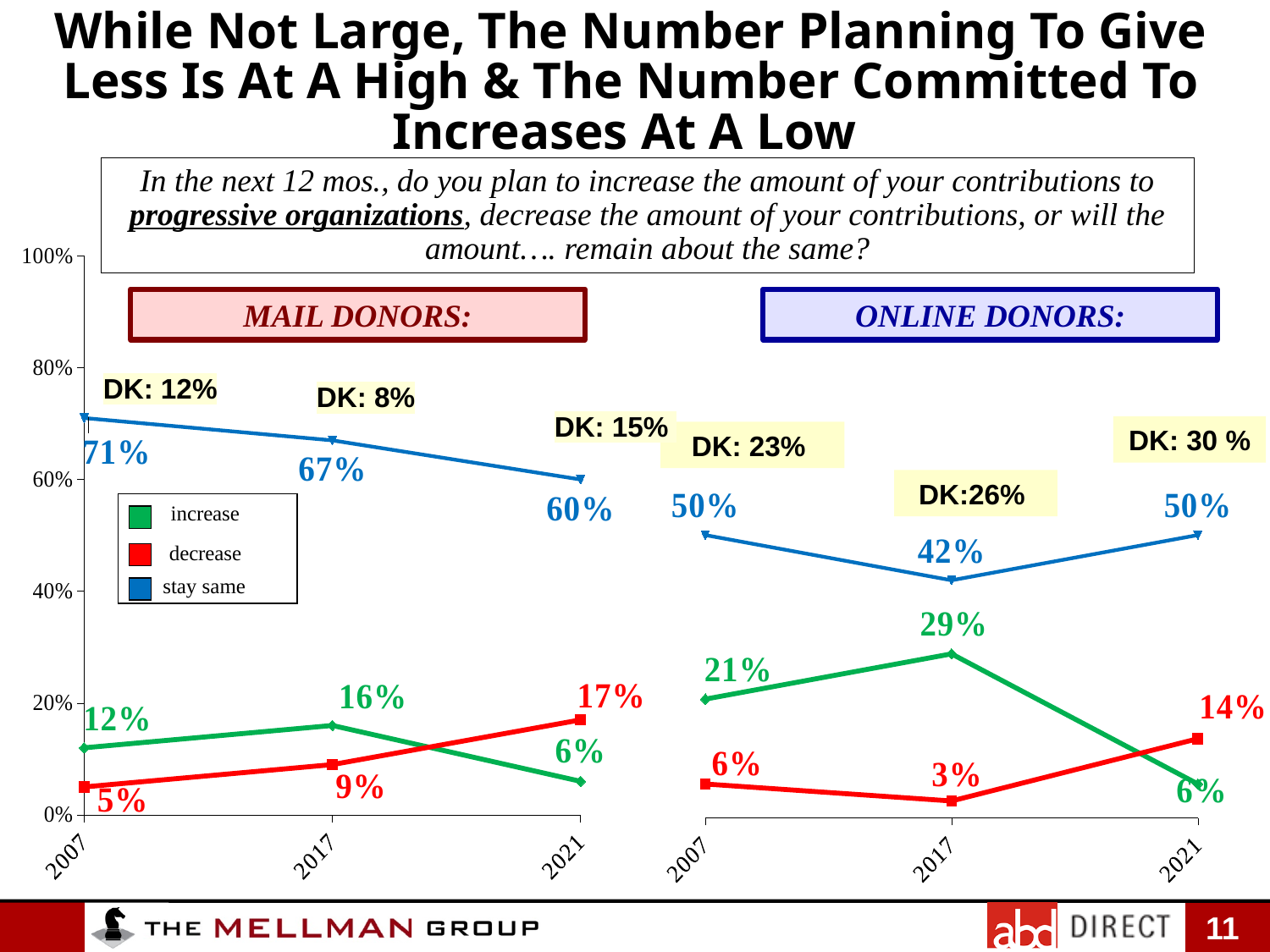
In the Mail Donors chart, what percentage planned to decrease contributions in 2021? 17% In the Online Donors chart, what percentage planned to decrease contributions in 2017? 3% In the Mail Donors chart, what percentage said they would stay the same in 2007? 71% How many series does the legend list? 3 In the Online Donors chart, in which year was the 'stay same' value lowest? 2017 How many years are plotted on the x axis of the Online Donors chart? 3 In the Online Donors chart, what percentage planned to increase contributions in 2017? 29% In the Mail Donors chart, in which year was the 'increase' value highest? 2017 In the Online Donors chart, which is larger in 2021: the 'decrease' value or the 'increase' value? decrease In the Mail Donors chart, what is the difference between the 'stay same' values for 2007 and 2021? 11 percentage points What type of chart is used on this slide? Line chart In the Mail Donors chart, does the 'decrease' line rise or fall from 2007 to 2021? Rise